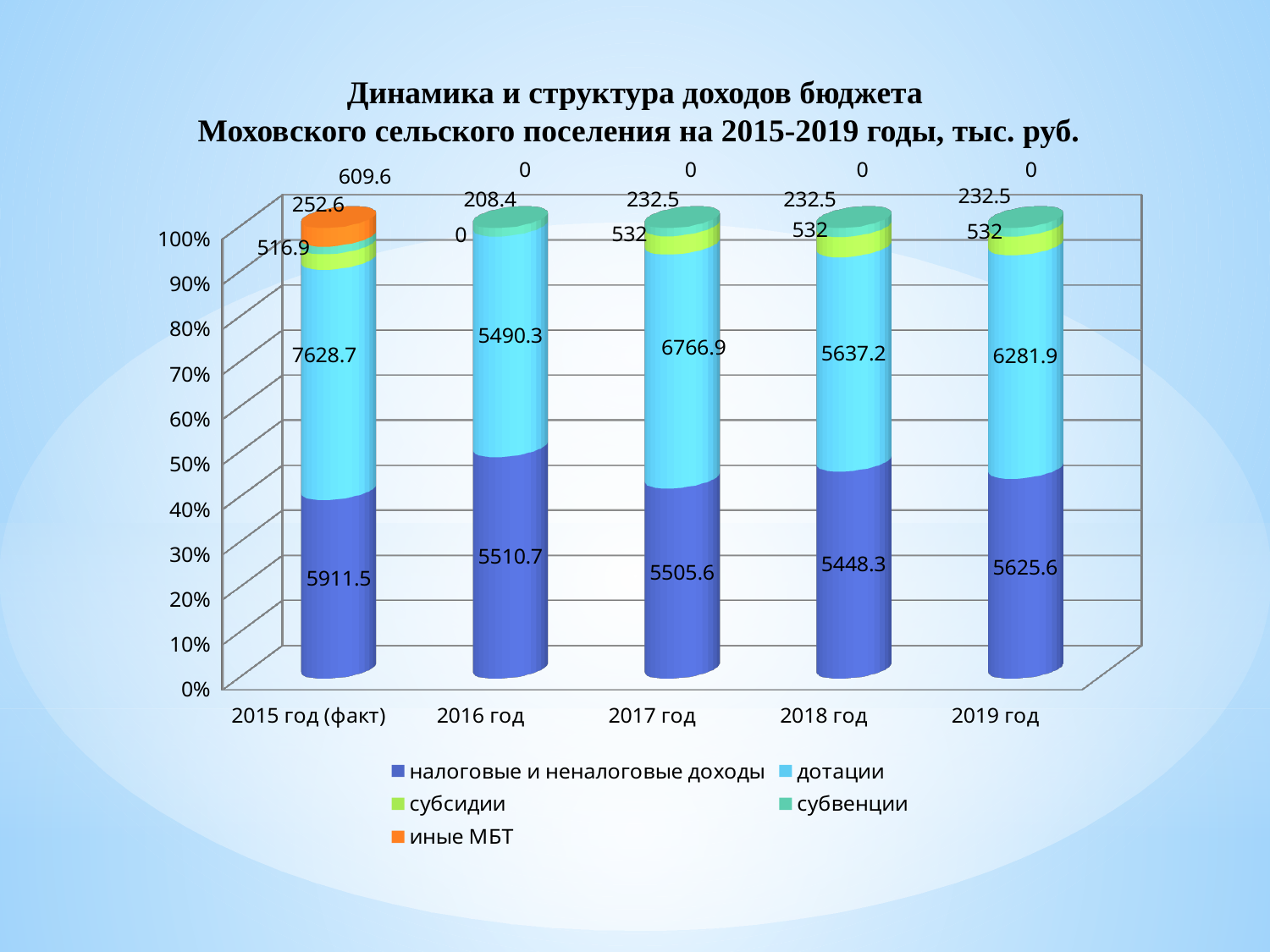
What kind of chart is shown on the slide? stacked bar chart In which year is the value of дотации the highest? 2015 год (факт) In 2016 год, which is larger: налоговые и неналоговые доходы or дотации? налоговые и неналоговые доходы In which year is the value of налоговые и неналоговые доходы the lowest? 2018 год What is the value of субвенции for 2016 год? 208.4 What is the value of дотации for 2017 год? 6766.9 What is the value of иные МБТ for 2015 год (факт)? 609.6 What is the difference between the дотации values for 2017 год and 2018 год? 1129.7 What is the value of налоговые и неналоговые доходы for 2019 год? 5625.6 How many years are shown on the x axis? 5 Is the share of налоговые и неналоговые доходы in 2015 год (факт) greater or less than 50%? less How many series does the legend list? 5